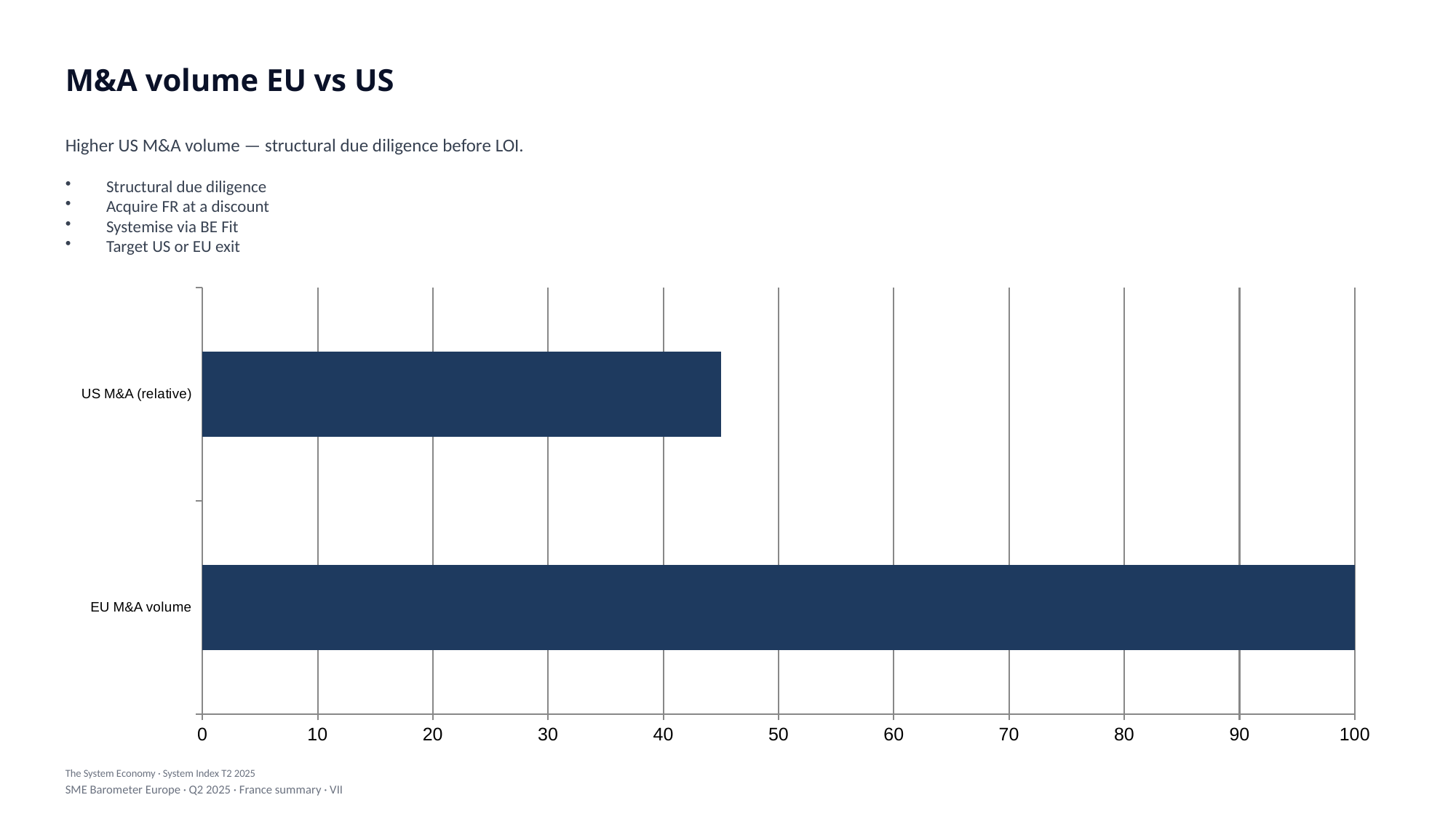
Is the value for US M&A (relative) greater or less than 50? less What is the maximum value shown on the horizontal axis of the chart? 100 What is the title of the slide containing the chart? M&A volume EU vs US Which category has the lowest value in the chart? US M&A (relative) How many categories are plotted in the chart? 2 Which is larger, the value for EU M&A volume or the value for US M&A (relative)? EU M&A volume What kind of chart is shown on the slide? bar chart Which category has the highest value in the chart? EU M&A volume What is the value for EU M&A volume? 100 Is the value for US M&A (relative) greater or less than 40? greater